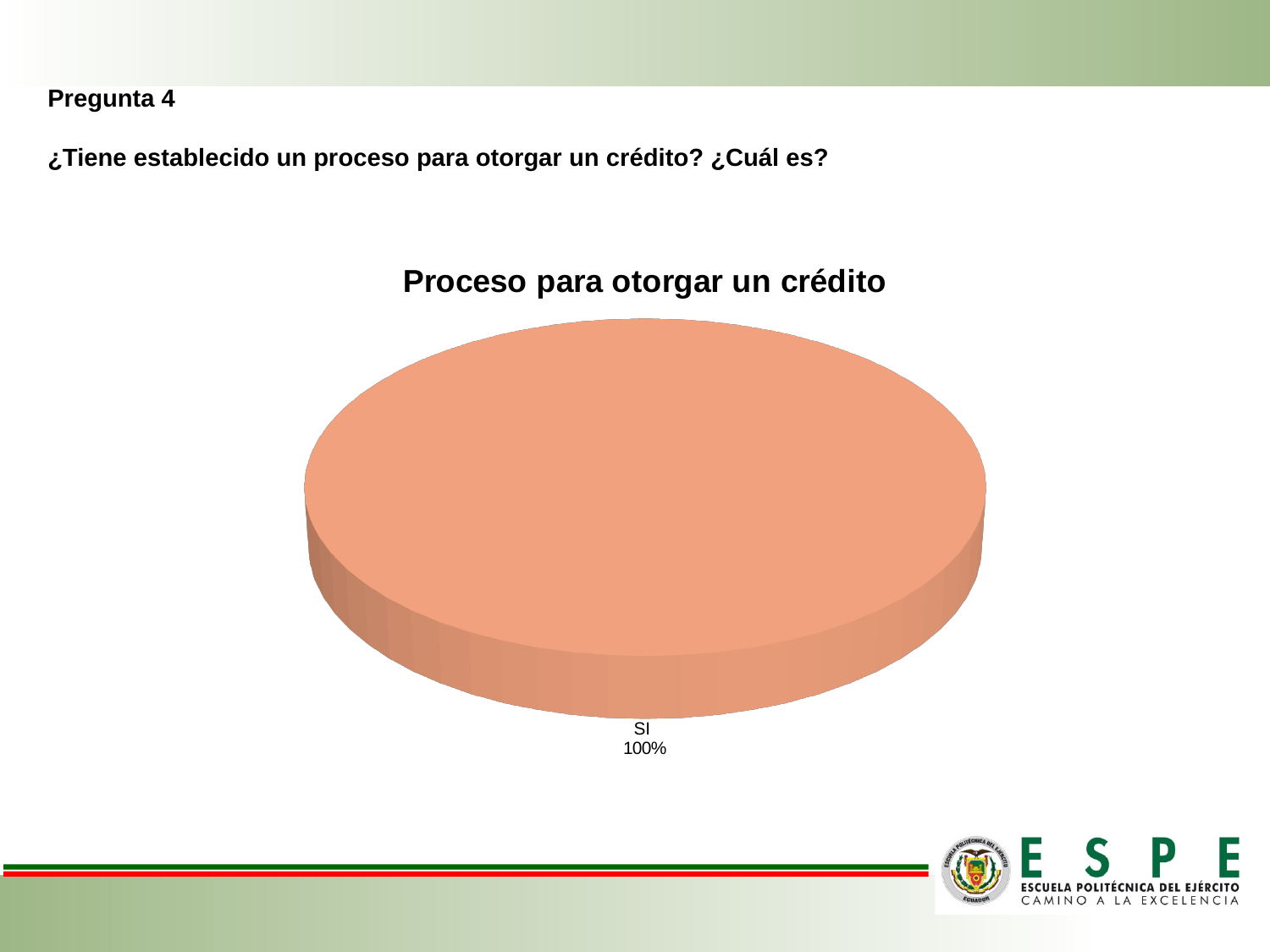
Which category is the largest slice of the pie? SI How many slices does the pie chart have? 1 What is the label of the only slice in the pie chart? SI What kind of chart is shown on the slide? pie chart What is the title of the chart? Proceso para otorgar un crédito What is the value shown for the SI category? 100% What share of the pie does the SI slice represent? 100%